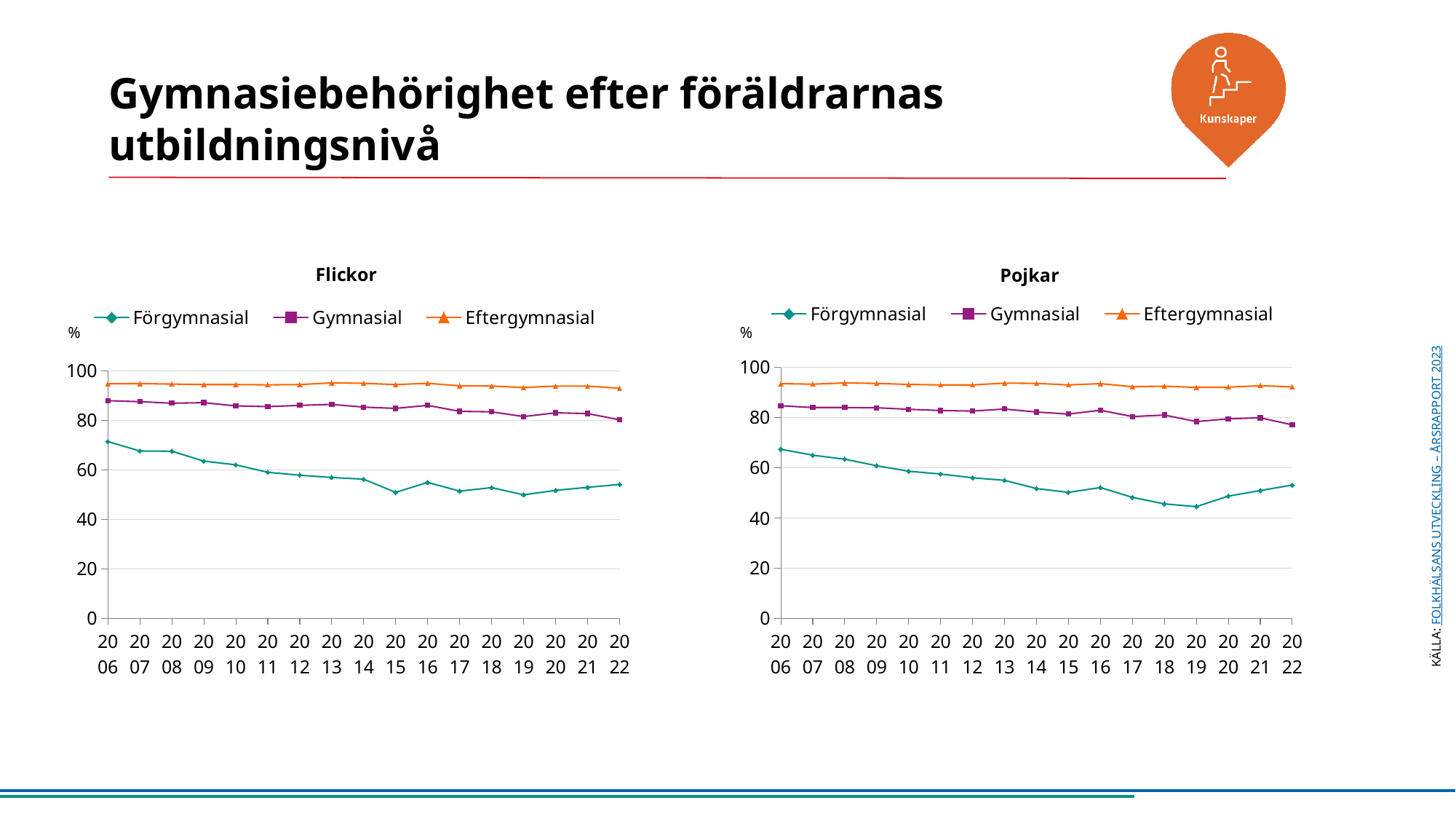
In the "Flickor" chart, does the Förgymnasial series generally rise or fall from 2006 to 2019? fall In the "Flickor" chart, is the value for Förgymnasial in 2006 greater or less than 60? greater How many years are plotted along the x axis of the "Flickor" chart? 17 What kind of chart is the "Flickor" chart? line chart How many series does the legend of the "Pojkar" chart list? 3 What is the title of the chart on the right side of the slide? Pojkar In the "Pojkar" chart, is the value for Förgymnasial in 2019 greater or less than 60? less In the "Pojkar" chart, is the value for Eftergymnasial in 2022 greater or less than 80? greater In the "Pojkar" chart, which series has the lowest values across the years? Förgymnasial In the "Flickor" chart, which series has the highest values across the years? Eftergymnasial What unit is shown on the y axis of the "Flickor" chart? % In the "Pojkar" chart, which is larger in 2022: Gymnasial or Förgymnasial? Gymnasial